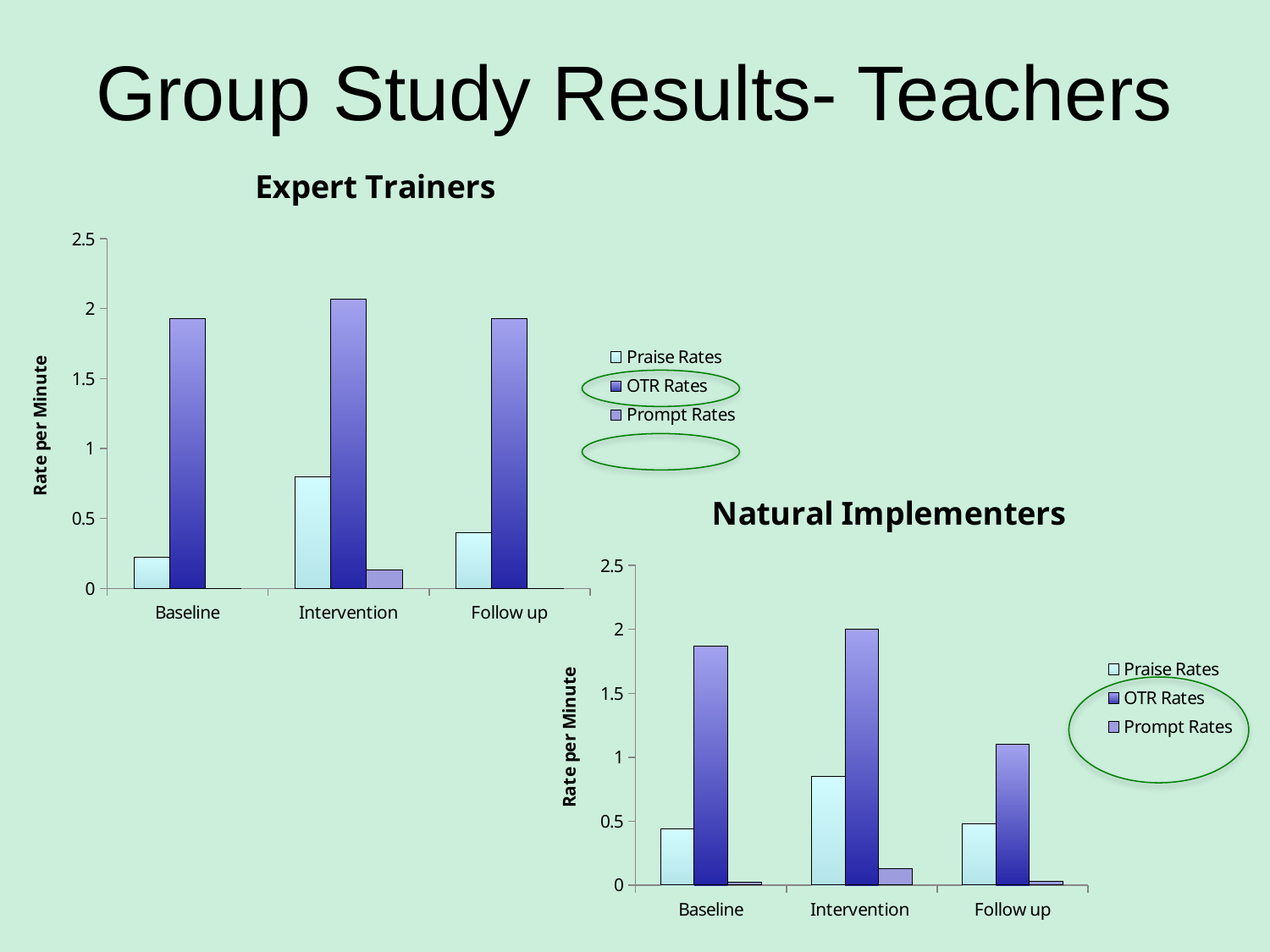
What is the y-axis label on the Expert Trainers chart? Rate per Minute How many categories are shown on the x axis of the Expert Trainers chart? 3 In the Natural Implementers chart, is the Prompt Rates value for Intervention greater or less than 0.5? less In the Expert Trainers chart, is the Praise Rates value for Intervention greater or less than 0.5? greater In the Expert Trainers chart, is the Praise Rates value for Baseline greater or less than 0.5? less In the Natural Implementers chart, do OTR Rates rise or fall from Intervention to Follow up? Fall In the Expert Trainers chart, which is larger: the Praise Rates value for Intervention or for Follow up? Intervention In the Natural Implementers chart, which phase has the lowest OTR Rates? Follow up In the Natural Implementers chart, which phase has the highest Praise Rates? Intervention What kind of chart is the Expert Trainers chart? Bar chart How many series does the legend of the Natural Implementers chart list? 3